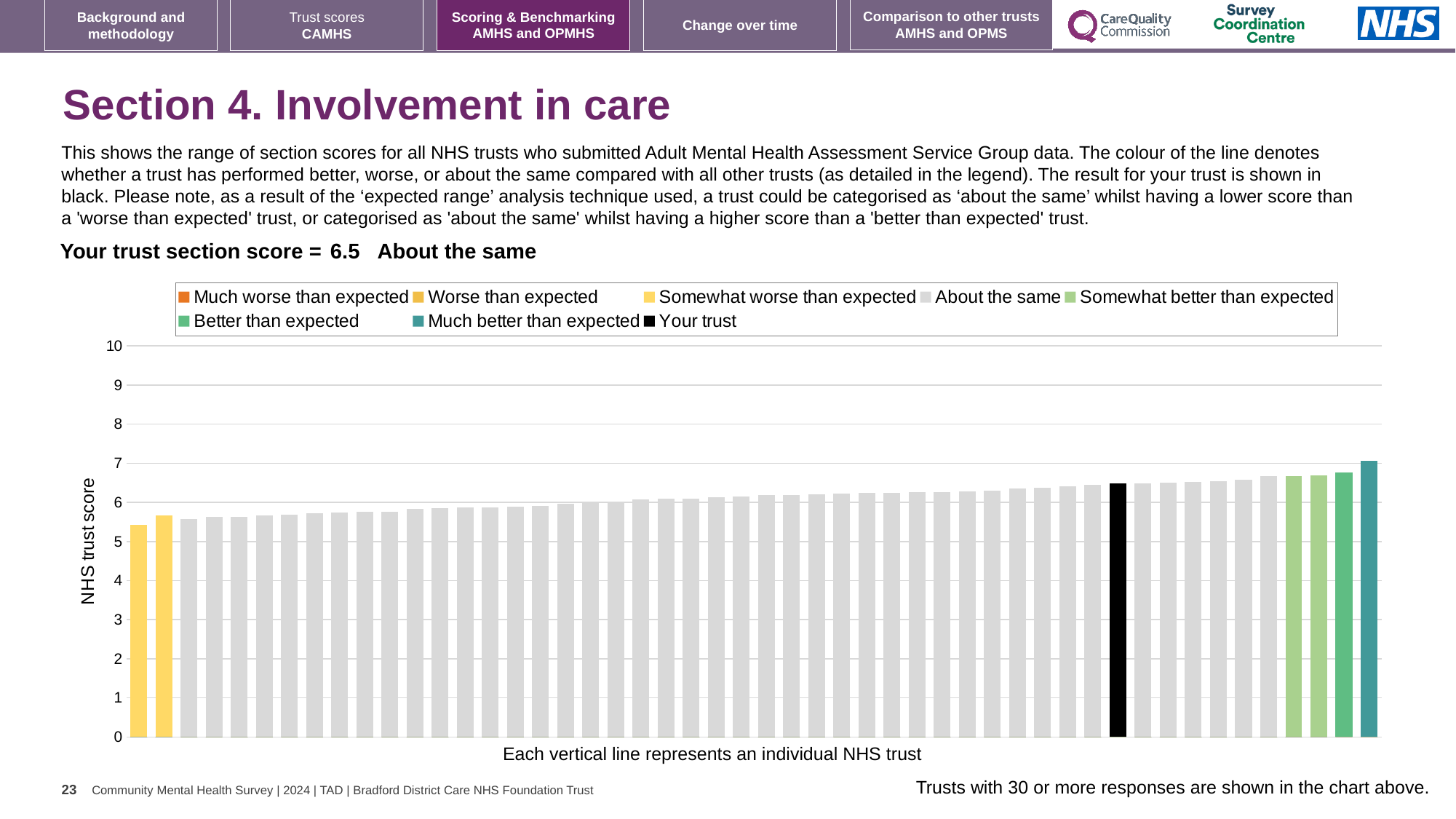
Do the bar values rise or fall from left to right across the chart? rise Which legend category does the lowest bar in the chart belong to? Somewhat worse than expected Is the value of the lowest bar in the chart greater or less than 6? less Which legend category does the highest bar in the chart belong to? Much better than expected How many entries does the chart legend list? 8 Is the value for your trust (the black bar) greater or less than 6? greater Which category does your trust fall into according to the slide? About the same How many bars are coloured as 'Worse than expected'? 0 What kind of chart is shown on the slide? bar chart What is the section score for your trust shown on the slide? 6.5 Is the value for your trust (the black bar) greater or less than 7? less What is the label on the vertical axis of the chart? NHS trust score